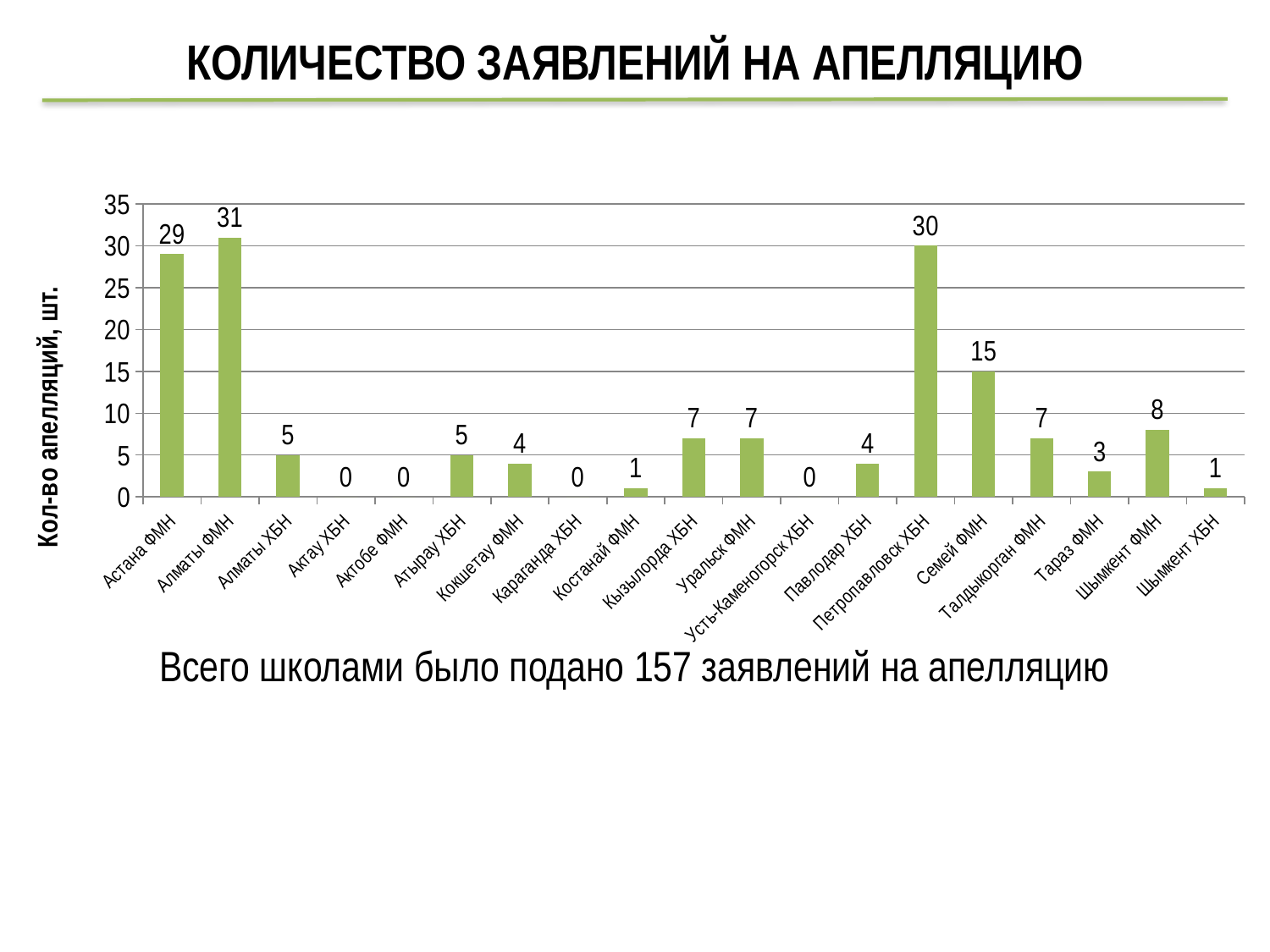
What is the value for Петропавловск ХБН? 30 How many categories have a value of 0? 4 What is the difference between the values for Алматы ФМН and Астана ФМН? 2 What is the title of the chart? КОЛИЧЕСТВО ЗАЯВЛЕНИЙ НА АПЕЛЛЯЦИЮ What is the value for Астана ФМН? 29 What is the value for Семей ФМН? 15 Which is larger, the value for Шымкент ФМН or the value for Талдыкорган ФМН? Шымкент ФМН What is the difference between the values for Петропавловск ХБН and Семей ФМН? 15 How many categories are shown on the x axis? 19 What is the value for Тараз ФМН? 3 What kind of chart is shown on the slide? bar chart Which category has the highest value? Алматы ФМН